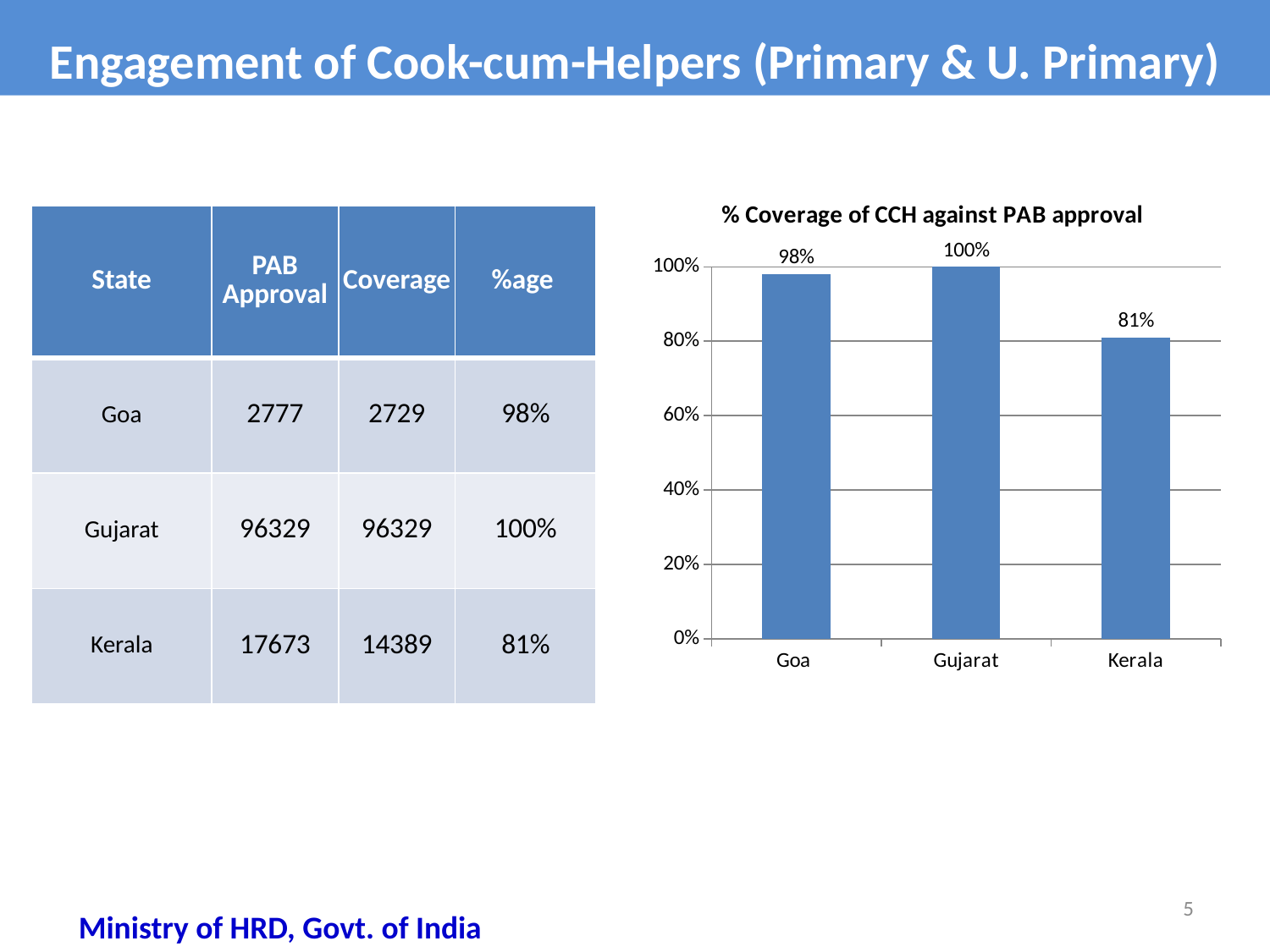
What is the title of the chart? % Coverage of CCH against PAB approval How many states are shown in the chart? 3 What is the value for Gujarat in the chart? 100% What is the difference between the values for Goa and Kerala? 17% What is the value for Goa in the chart? 98% What is the difference between the values for Gujarat and Kerala? 19% Which state has the highest value in the chart? Gujarat Which state has the lowest value in the chart? Kerala Is the value for Kerala greater or less than 60%? greater What kind of chart is shown on the slide? Bar chart Which is larger, the value for Goa or the value for Kerala? Goa What is the value for Kerala in the chart? 81%